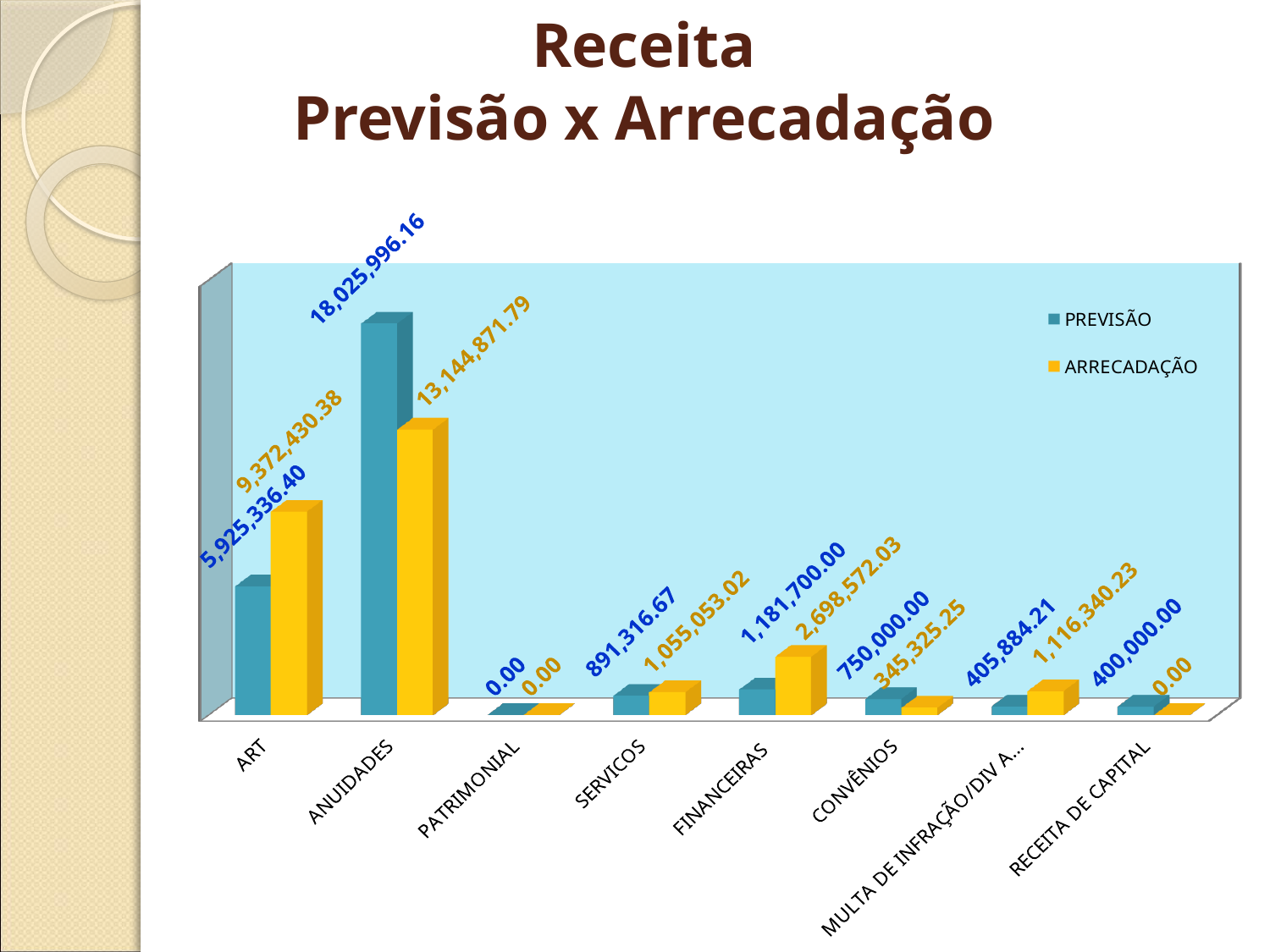
Which category has the highest ARRECADAÇÃO value? ANUIDADES What is the ARRECADAÇÃO value for FINANCEIRAS? 2,698,572.03 For CONVÊNIOS, which is larger: PREVISÃO or ARRECADAÇÃO? PREVISÃO What is the difference between the ARRECADAÇÃO and PREVISÃO values for ART? 3,447,093.98 What is the difference between the PREVISÃO and ARRECADAÇÃO values for ANUIDADES? 4,881,124.37 How many categories are shown on the x axis? 8 What is the PREVISÃO value for RECEITA DE CAPITAL? 400,000.00 How many series does the legend list? 2 Which category has the highest PREVISÃO value? ANUIDADES What kind of chart is shown on the slide? Bar chart What is the ARRECADAÇÃO value for ART? 9,372,430.38 What is the PREVISÃO value for ANUIDADES? 18,025,996.16